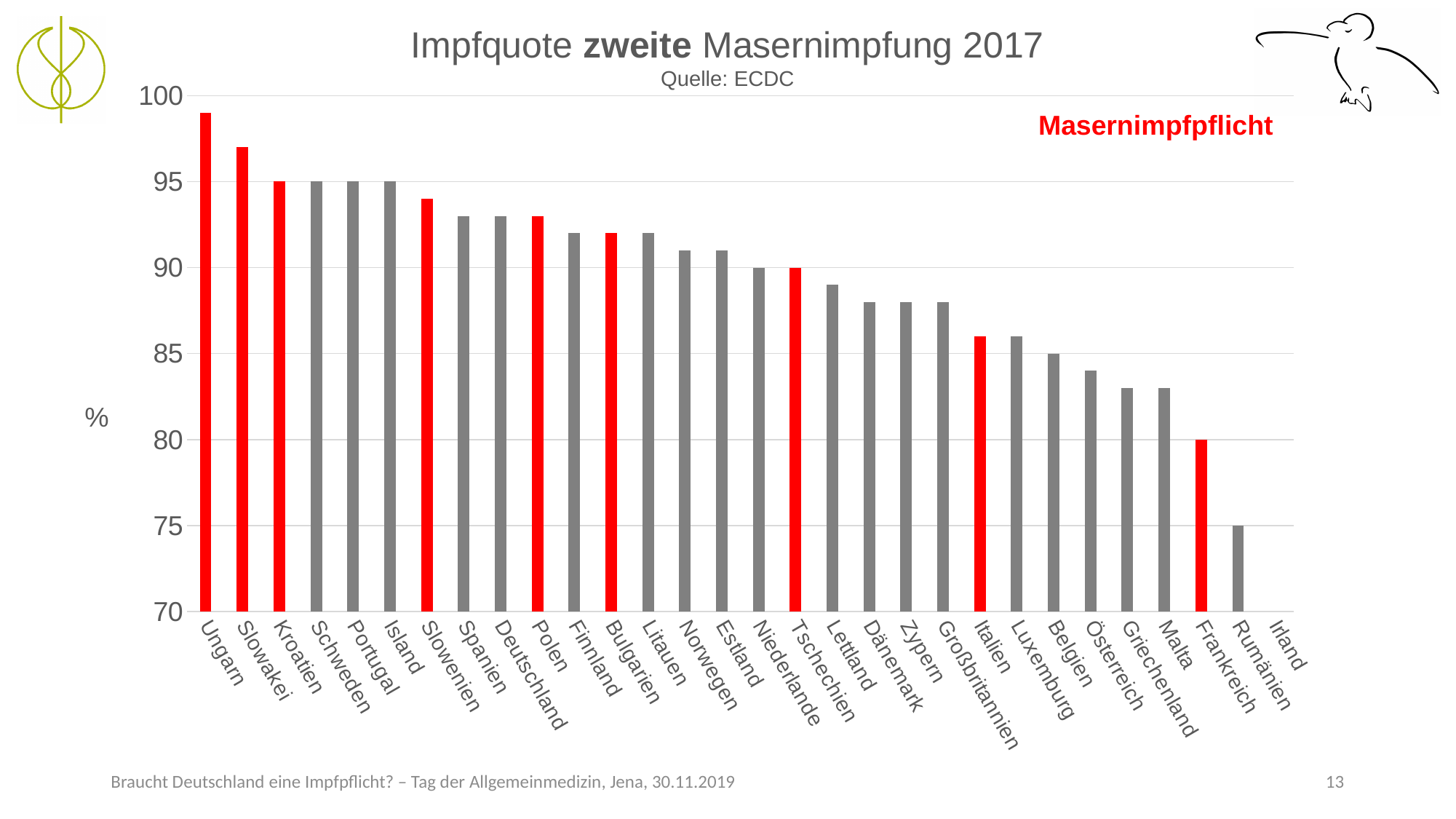
What kind of chart is shown on the slide? bar chart What do the red bars in the chart indicate, according to the label on the slide? Masernimpfpflicht Which has the larger value, Deutschland or Italien? Deutschland Which country has the highest vaccination rate in the chart? Ungarn What is the title of the chart? Impfquote zweite Masernimpfung 2017 What is the value for Rumänien? 75 Is the value for Griechenland greater or less than 85? less Is the value for Deutschland greater or less than 90? greater Do the values rise or fall from left to right along the x axis? fall Is the value for Slowakei greater or less than 95? greater What is the value for Frankreich? 80 What is the value for Niederlande? 90